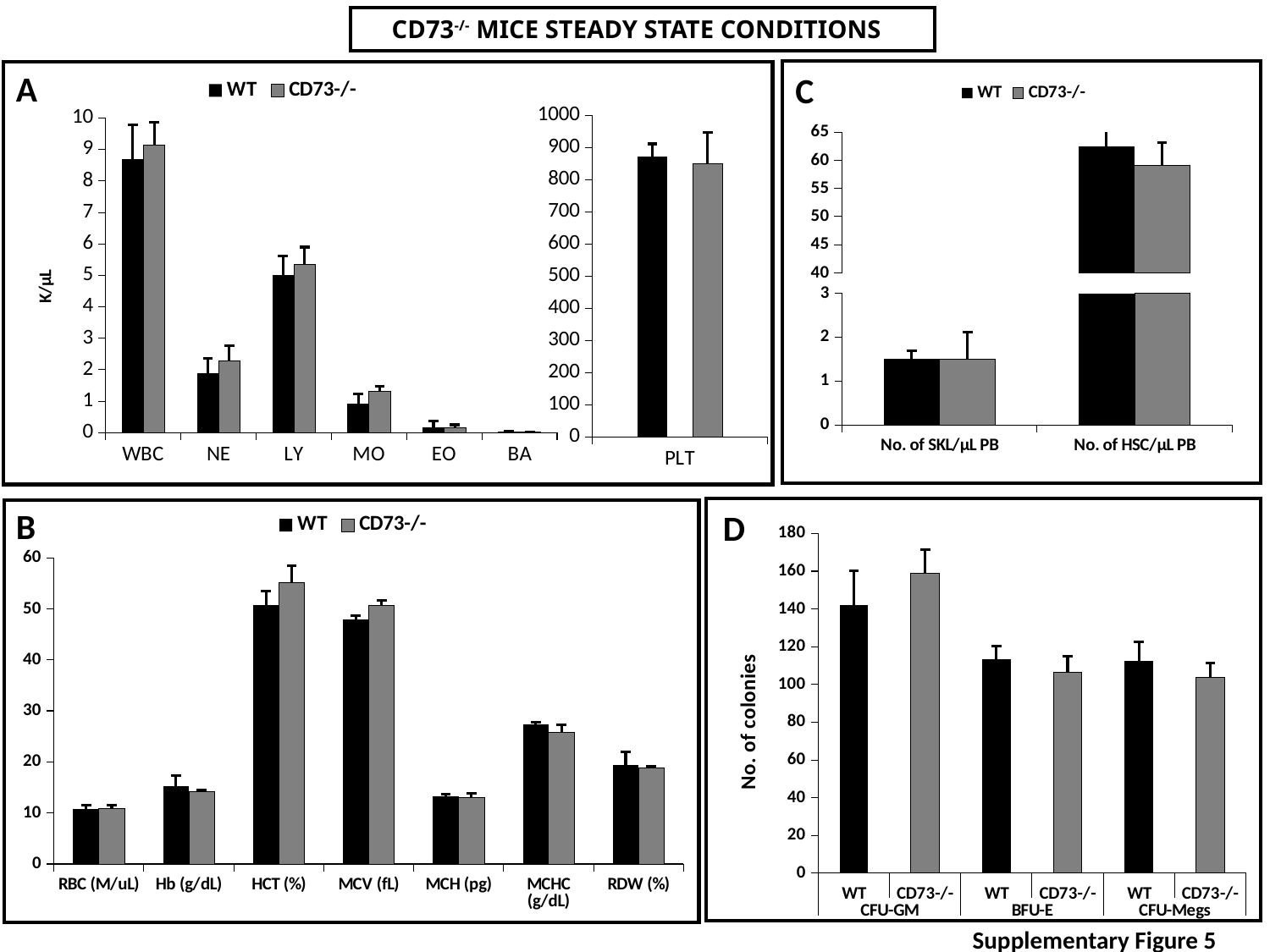
In panel D, which is larger: the WT value for CFU-GM or the WT value for BFU-E? WT CFU-GM In panel A, which of the six blood cell categories has the lowest bars? BA In panel B, is the CD73-/- value for HCT (%) greater or less than 50? greater In panel A, is the WT value for WBC greater or less than 8? greater In panel C, is the WT value for No. of HSC/µL PB greater or less than 60? greater In panel A, what is the y-axis label of the left chart? K/µL In panel B, how many categories are shown on the x axis? 7 In panel D, which bar is the highest? CD73-/- CFU-GM In panel C, how many series does the legend list? 2 In panel B, which category has the highest bars? HCT (%)